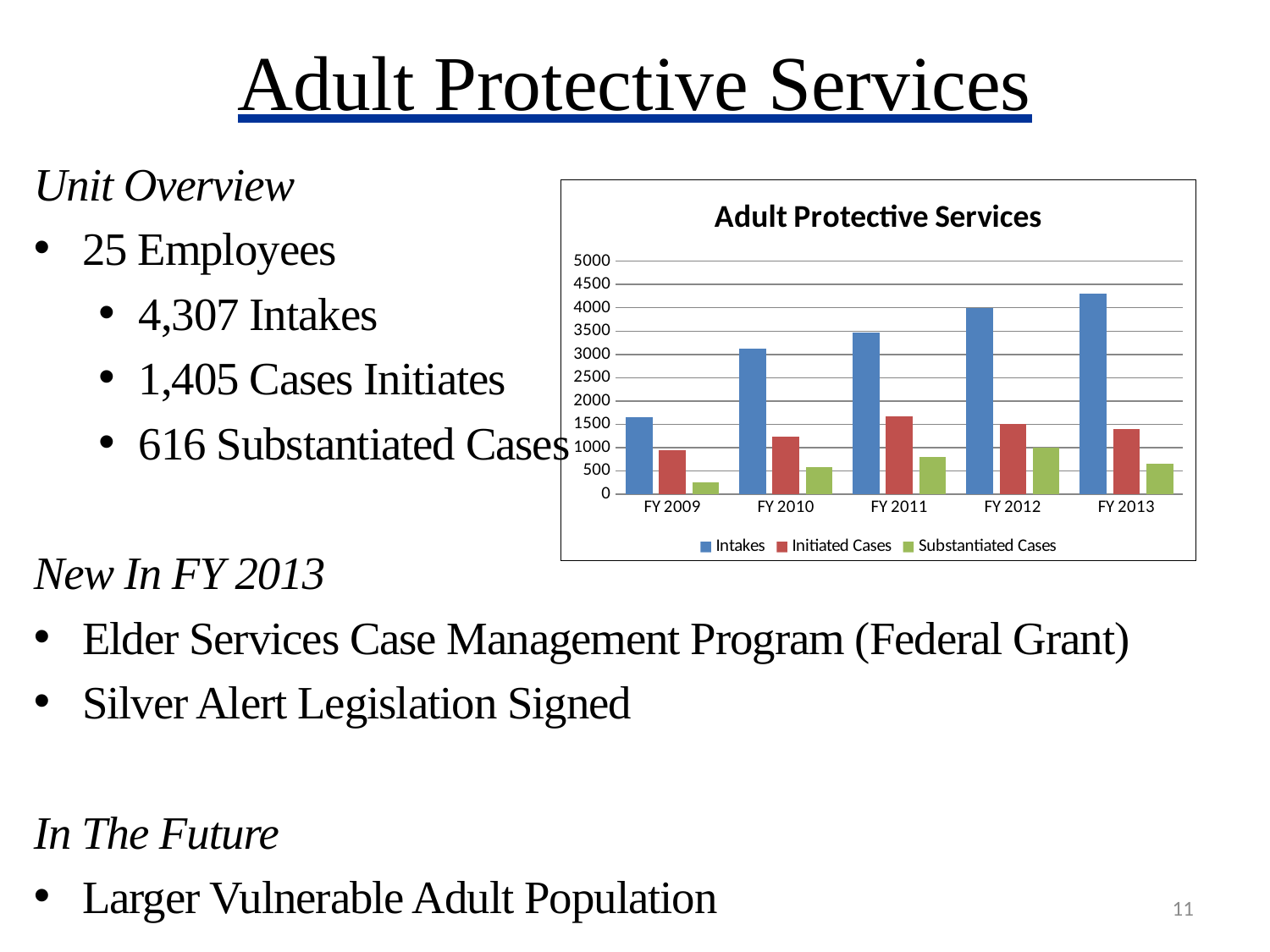
Which fiscal year has the highest Intakes value? FY 2013 Which fiscal year has the highest Initiated Cases value? FY 2011 Is the Substantiated Cases value for FY 2009 greater or less than 500? less What is the title of the chart? Adult Protective Services Is the Intakes value for FY 2013 greater or less than 4000? greater Which is larger, Intakes in FY 2011 or Intakes in FY 2012? FY 2012 How many fiscal years are shown on the x axis of the chart? 5 What kind of chart is shown on the slide? bar chart Which fiscal year has the lowest Substantiated Cases value? FY 2009 How many series does the chart legend list? 3 Which fiscal year has the lowest Intakes value? FY 2009 Do Intakes rise or fall from FY 2009 to FY 2013? rise